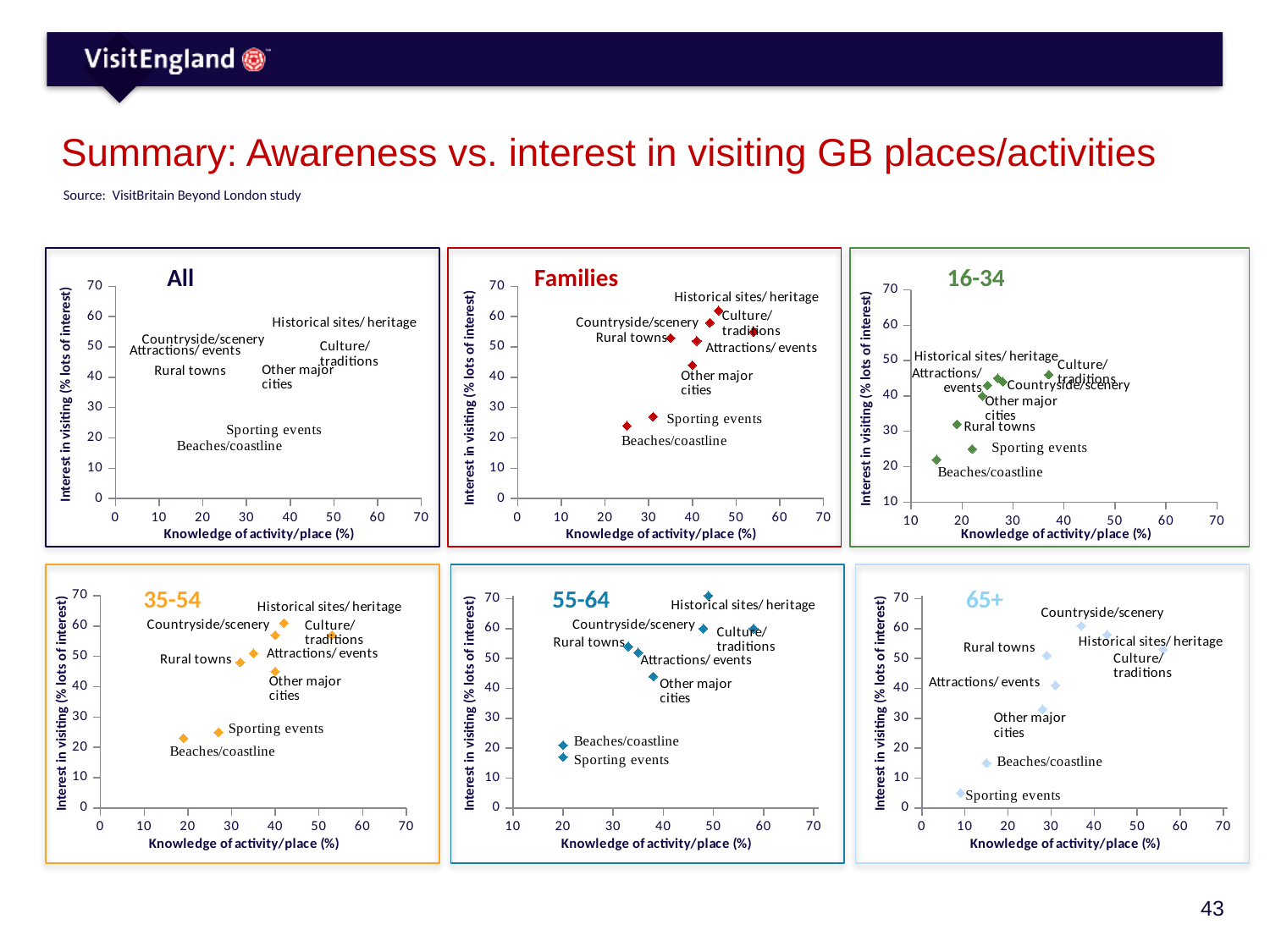
In the '55-64' chart, is the interest in visiting for Historical sites/heritage greater or less than 60? greater What is the x-axis title of the charts on the slide? Knowledge of activity/place (%) What kind of chart is the 'Families' chart? scatter chart In the '35-54' chart, is the knowledge of activity/place for Beaches/coastline greater or less than 30? less In the '35-54' chart, is the interest in visiting for Historical sites/heritage greater or less than 50? greater In the 'Families' chart, which activity/place has the highest interest in visiting? Historical sites/heritage In the '55-64' chart, which activity/place has the highest interest in visiting? Historical sites/heritage In the '65+' chart, which activity/place has the lowest interest in visiting? Sporting events How many charts are shown on the slide? 6 In the '65+' chart, which has the higher interest in visiting: Countryside/scenery or Beaches/coastline? Countryside/scenery